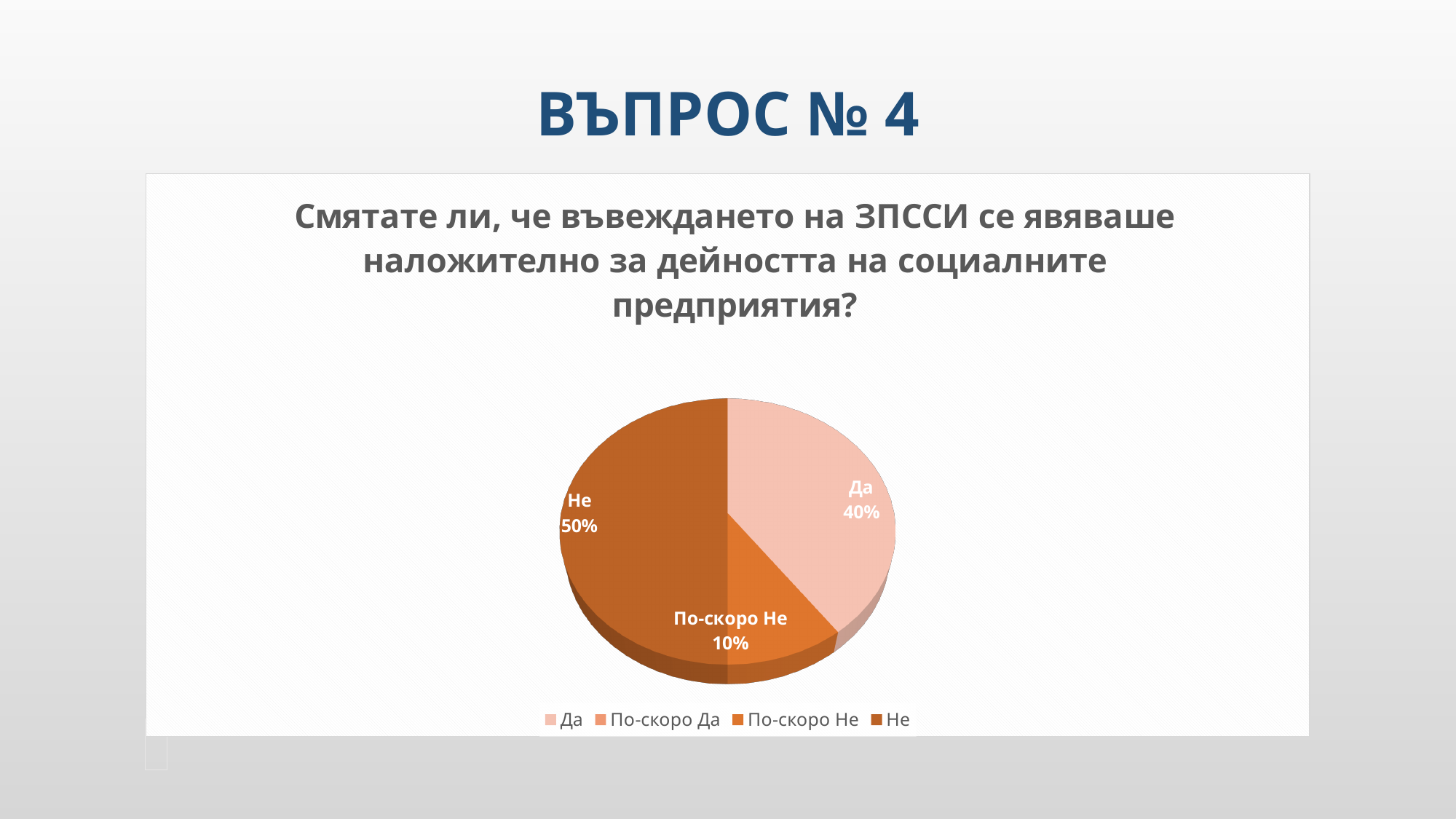
Which answer has the largest slice of the pie? Не Which is larger, the share for "Да" or the share for "По-скоро Не"? Да What kind of chart is shown on the slide? Pie chart What share of the pie does "По-скоро Не" represent? 10% How many entries does the legend list? 4 What is the difference in percentage points between "Да" and "По-скоро Не"? 30 How many slices with data labels are visible in the pie? 3 What share of the pie does "Да" represent? 40% What share of the pie does "Не" represent? 50% Which legend entry has no visible slice in the pie? По-скоро Да What is the difference in percentage points between "Не" and "Да"? 10 Which labelled slice of the pie is the smallest? По-скоро Не